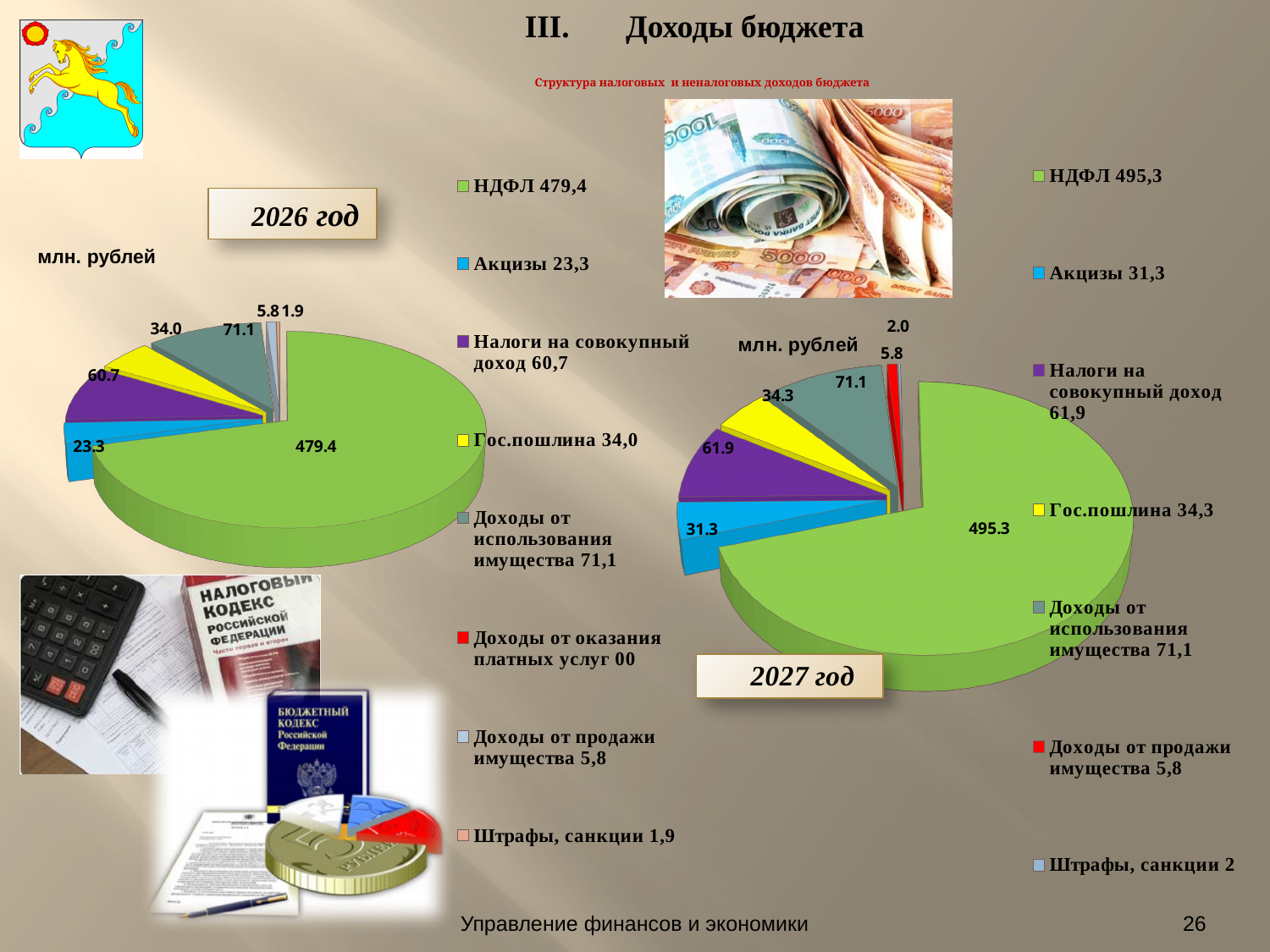
How much larger is НДФЛ in the 2027 год chart than in the 2026 год chart? 15.9 How many entries does the legend of the 2027 год chart list? 7 What unit is stated for the values in both charts? млн. рублей What type of chart is used for the 2026 год data? Pie chart In the 2027 год pie chart, what is the value for Гос.пошлина? 34.3 In the 2026 год pie chart, which is larger: Акцизы or Гос.пошлина? Гос.пошлина In the 2027 год pie chart, which category has the smallest value? Штрафы, санкции In the 2026 год pie chart, which category has the largest slice? НДФЛ In the 2026 год pie chart, what is the value for НДФЛ? 479.4 In the 2027 год pie chart, what is the value for Акцизы? 31.3 In the 2026 год pie chart, what is the value for Доходы от использования имущества? 71.1 In the 2026 год pie chart, what is the difference between Налоги на совокупный доход and Гос.пошлина? 26.7